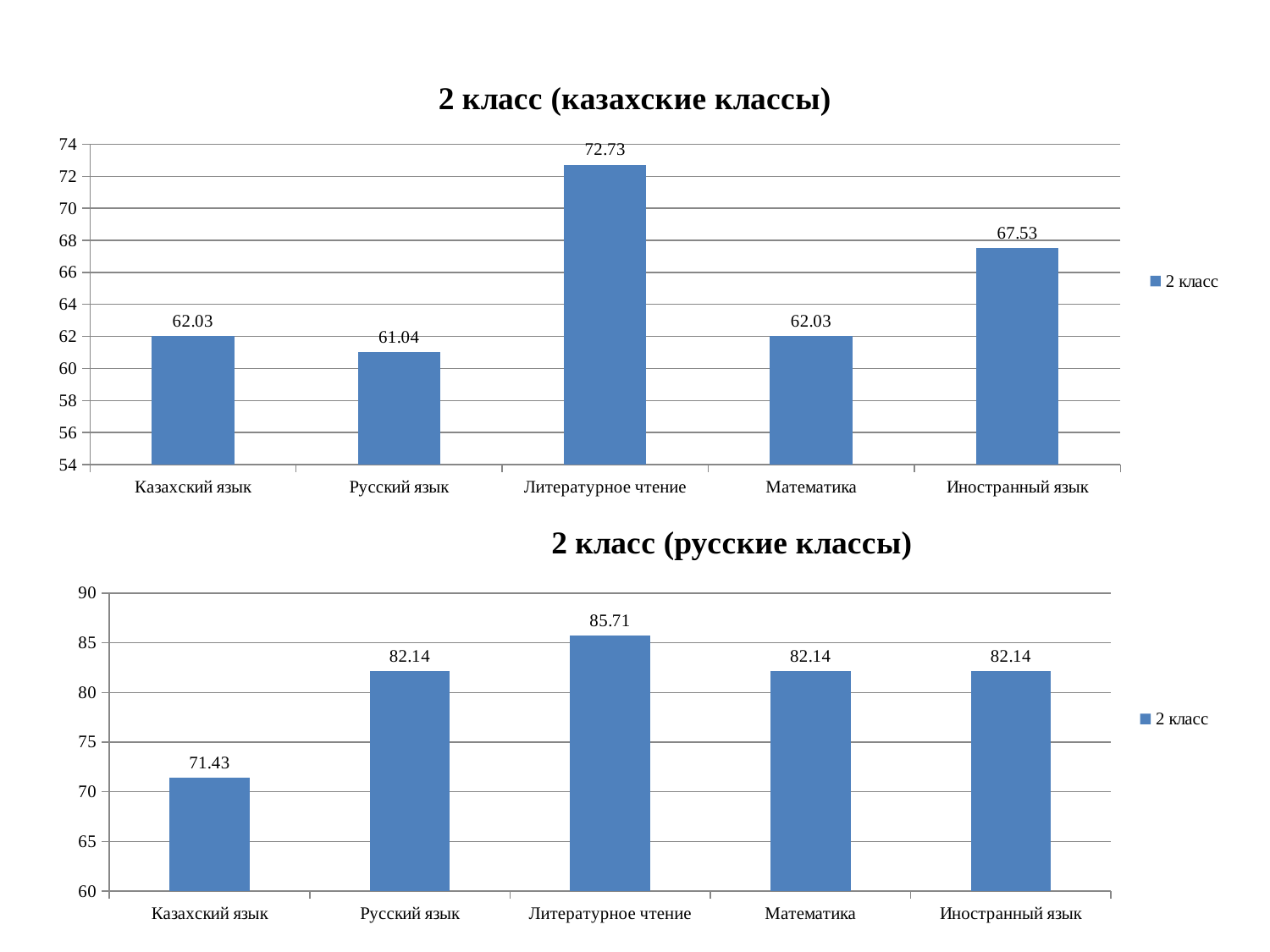
In the chart titled "2 класс (русские классы)", what is the value for Казахский язык? 71.43 In the chart titled "2 класс (казахские классы)", which category has the lowest value? Русский язык In the chart titled "2 класс (казахские классы)", is the value for Иностранный язык greater or less than 66? greater What kind of chart is the chart titled "2 класс (русские классы)"? Bar chart In the chart titled "2 класс (казахские классы)", what is the value for Литературное чтение? 72.73 In the chart titled "2 класс (русские классы)", what is the difference between the values for Литературное чтение and Русский язык? 3.57 In the chart titled "2 класс (казахские классы)", how many categories are shown on the x axis? 5 In the chart titled "2 класс (русские классы)", how many series does the legend list? 1 In the chart titled "2 класс (русские классы)", which is larger, the value for Казахский язык or the value for Математика? Математика In the chart titled "2 класс (казахские классы)", what is the legend entry? 2 класс In the chart titled "2 класс (русские классы)", which category has the highest value? Литературное чтение In the chart titled "2 класс (казахские классы)", what is the difference between the values for Литературное чтение and Иностранный язык? 5.20